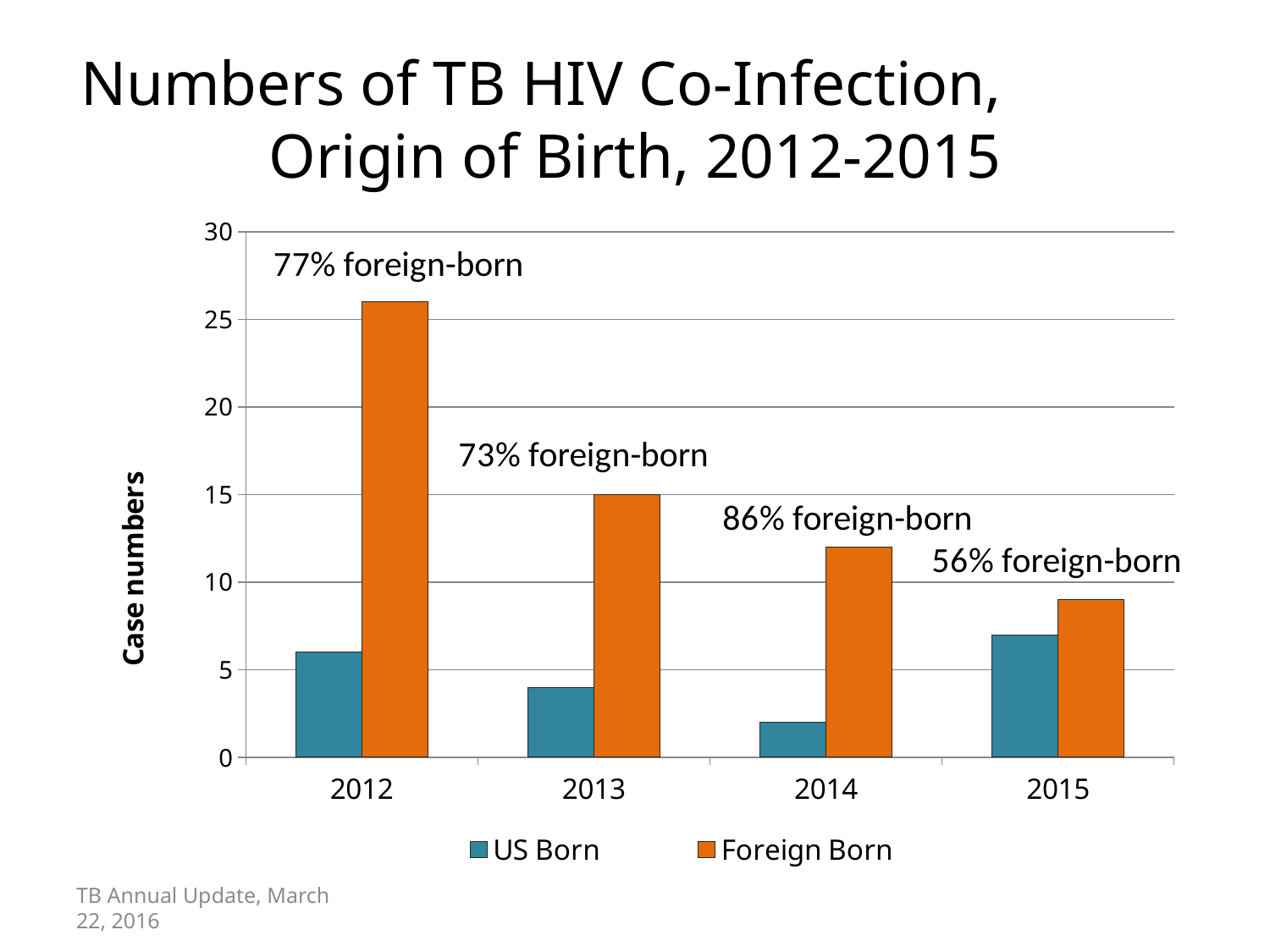
In which year is the US Born bar lowest? 2014 In which year is the Foreign Born bar highest? 2012 What percentage foreign-born is annotated above the 2014 bars? 86% foreign-born Do the Foreign Born values rise or fall from 2012 to 2015? fall Which is larger, the Foreign Born value for 2012 or the Foreign Born value for 2014? 2012 Is the Foreign Born value for 2015 greater or less than 10? less What type of chart is shown on the slide? bar chart Is the Foreign Born value for 2012 greater or less than 25? greater How many series does the legend list? 2 Is the US Born value for 2014 greater or less than 5? less How many years are shown on the x axis? 4 What is the Foreign Born value for 2013? 15